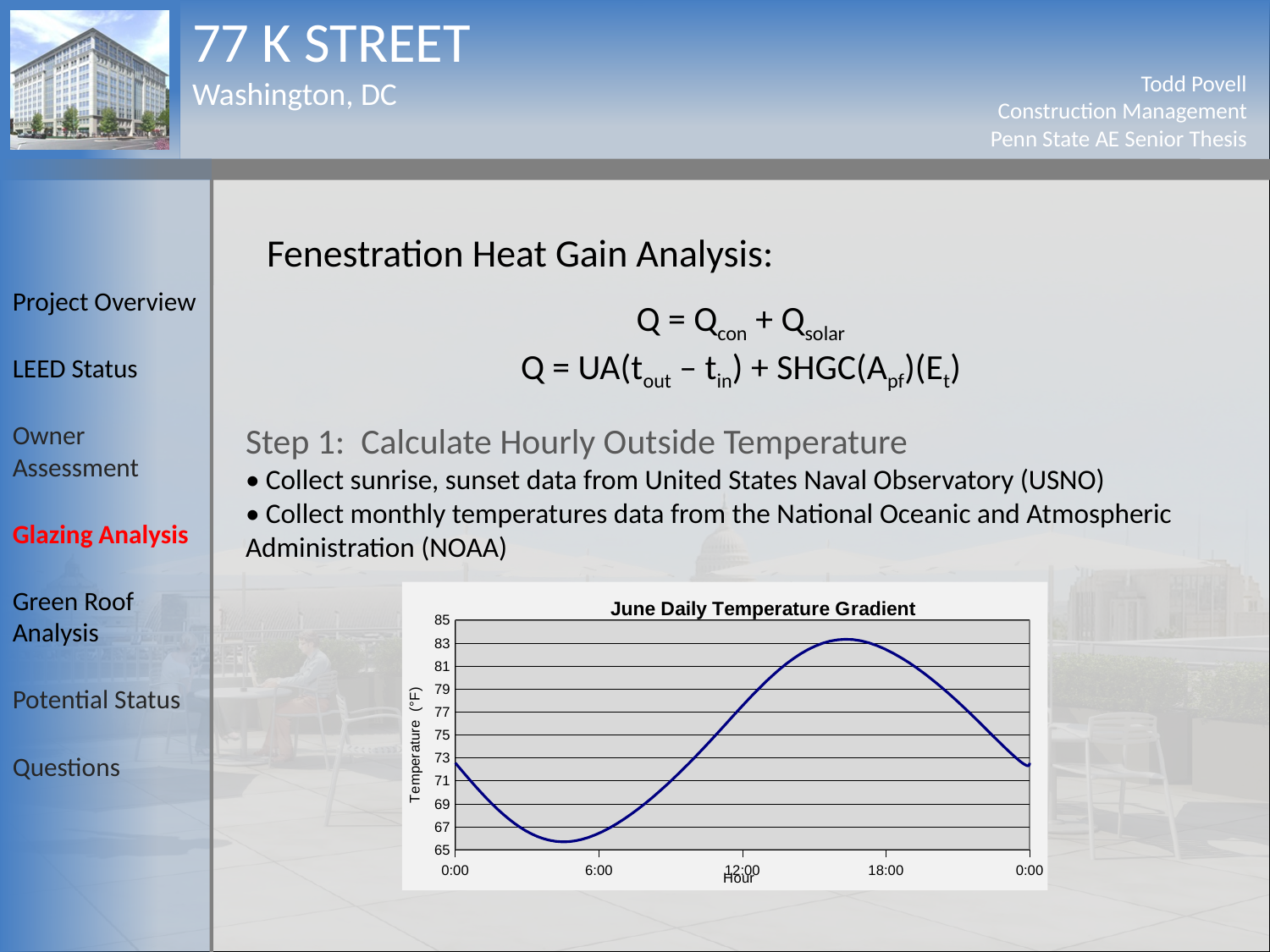
Is the temperature at the start of the day (0:00) greater or less than 75? less What is the title of the chart? June Daily Temperature Gradient What is the label of the vertical axis of the chart? Temperature (°F) What kind of chart is shown on the slide? line chart Is the temperature at 6:00 greater or less than 70? less Of the labelled hours 0:00, 6:00, 12:00 and 18:00, at which is the temperature lowest? 6:00 Which is higher, the temperature at 12:00 or at 6:00? 12:00 Does the temperature rise or fall between 18:00 and the final 0:00? fall Is the highest temperature reached on the curve greater or less than 80? greater Does the temperature rise or fall between 6:00 and 12:00? rise